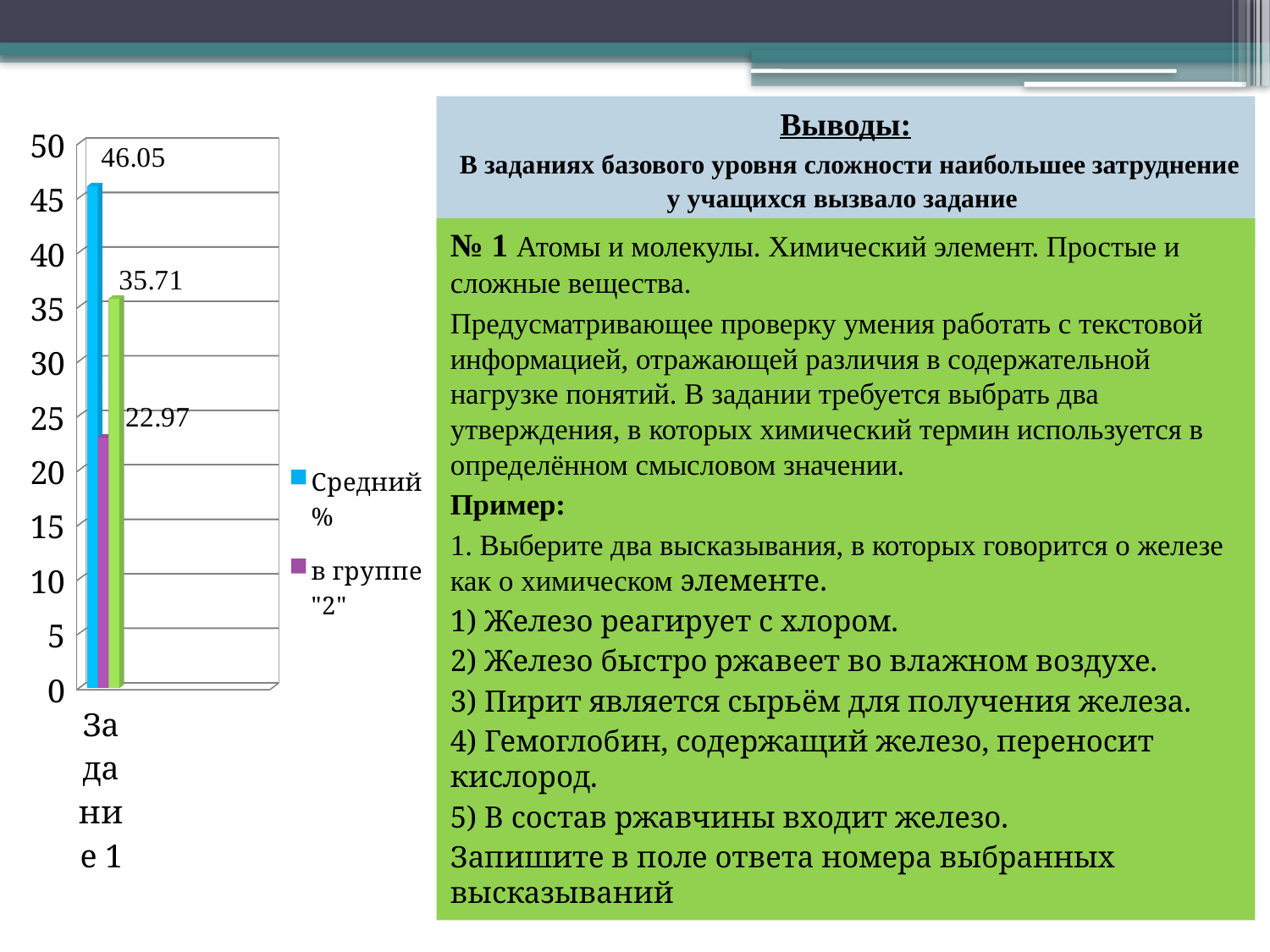
What is the value of the "в группе "2"" series for Задание 1? 22.97 What kind of chart is shown on the slide? bar chart What is the difference between the "Средний %" value and the "в группе "2"" value for Задание 1? 23.08 Which series has the highest value for Задание 1? Средний % Is the value for "Средний %" greater or less than 40? greater What is the lowest value shown on the chart? 22.97 How many series does the legend list? 2 Is the value for "в группе "2"" greater or less than 25? less How many categories are shown on the x axis of the chart? 1 Which is larger for Задание 1: "Средний %" or "в группе "2""? Средний % What is the value of the "Средний %" series for Задание 1? 46.05 What is the highest value shown on the chart? 46.05